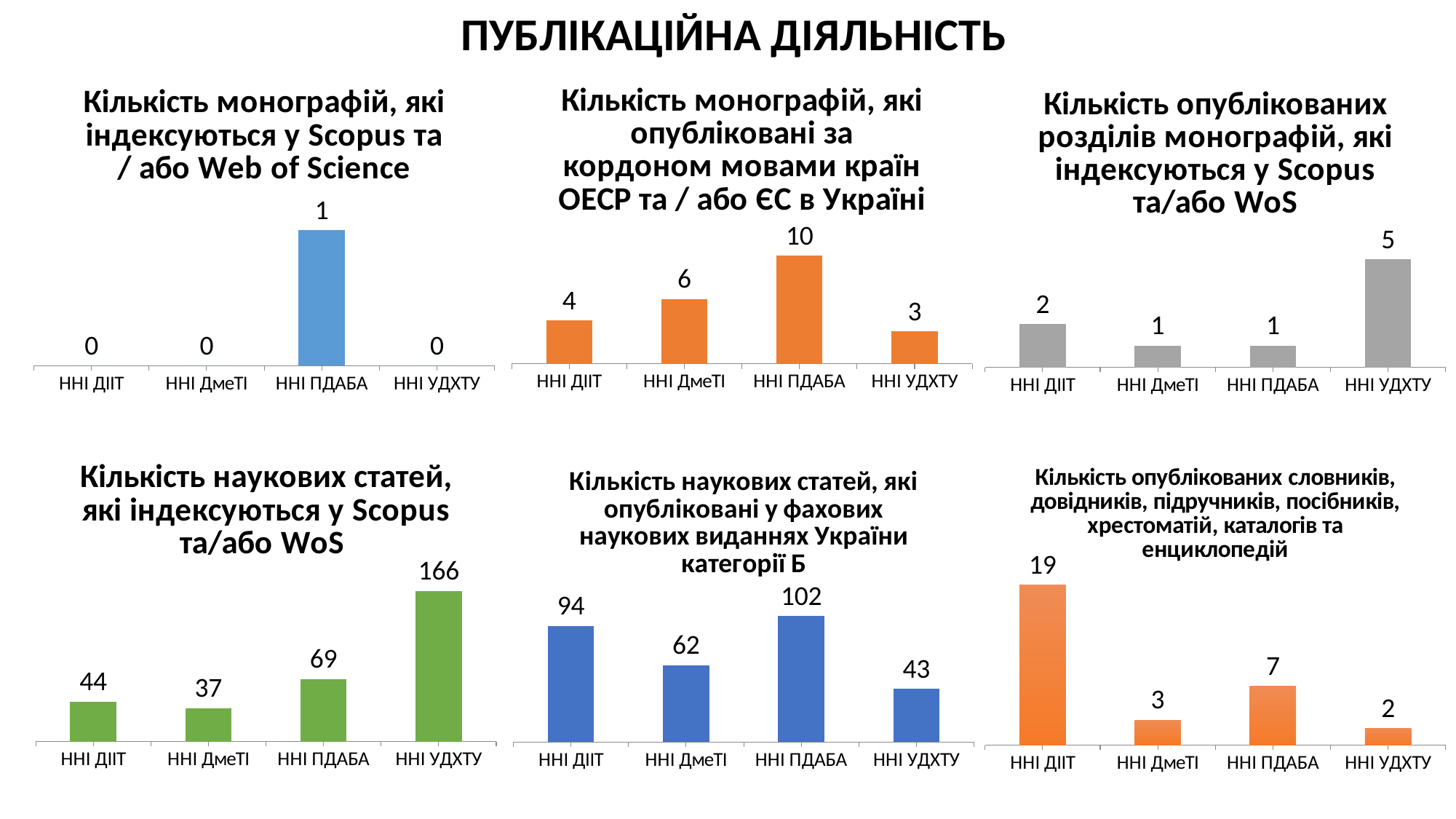
In the top-middle chart (monographs published abroad in OECD/EU languages), what is the difference between ННІ ПДАБА and ННІ УДХТУ? 7 In the bottom-left chart (scientific articles indexed in Scopus and/or WoS), what is the value for ННІ УДХТУ? 166 In the top-right chart (chapters of monographs indexed in Scopus and/or WoS), what is the value for ННІ УДХТУ? 5 How many categories are shown in the bottom-right chart (dictionaries, handbooks, textbooks, etc.)? 4 In the top-left chart (monographs indexed in Scopus and/or Web of Science), what is the value for ННІ ПДАБА? 1 In the bottom-right chart (dictionaries, handbooks, textbooks, etc.), what is the value for ННІ ДІІТ? 19 In the top-right chart (chapters of monographs indexed in Scopus and/or WoS), which is larger: ННІ ДІІТ or ННІ ДмеТІ? ННІ ДІІТ In the bottom-left chart (scientific articles indexed in Scopus and/or WoS), which category has the lowest value? ННІ ДмеТІ What type of chart is the bottom-left chart (scientific articles indexed in Scopus and/or WoS)? Bar chart In the top-middle chart (monographs published abroad in OECD/EU languages), which category has the highest value? ННІ ПДАБА In the bottom-middle chart (articles in Ukrainian category Б journals), which category has the lowest value? ННІ УДХТУ In the bottom-middle chart (articles in Ukrainian category Б journals), what is the difference between ННІ ПДАБА and ННІ ДІІТ? 8